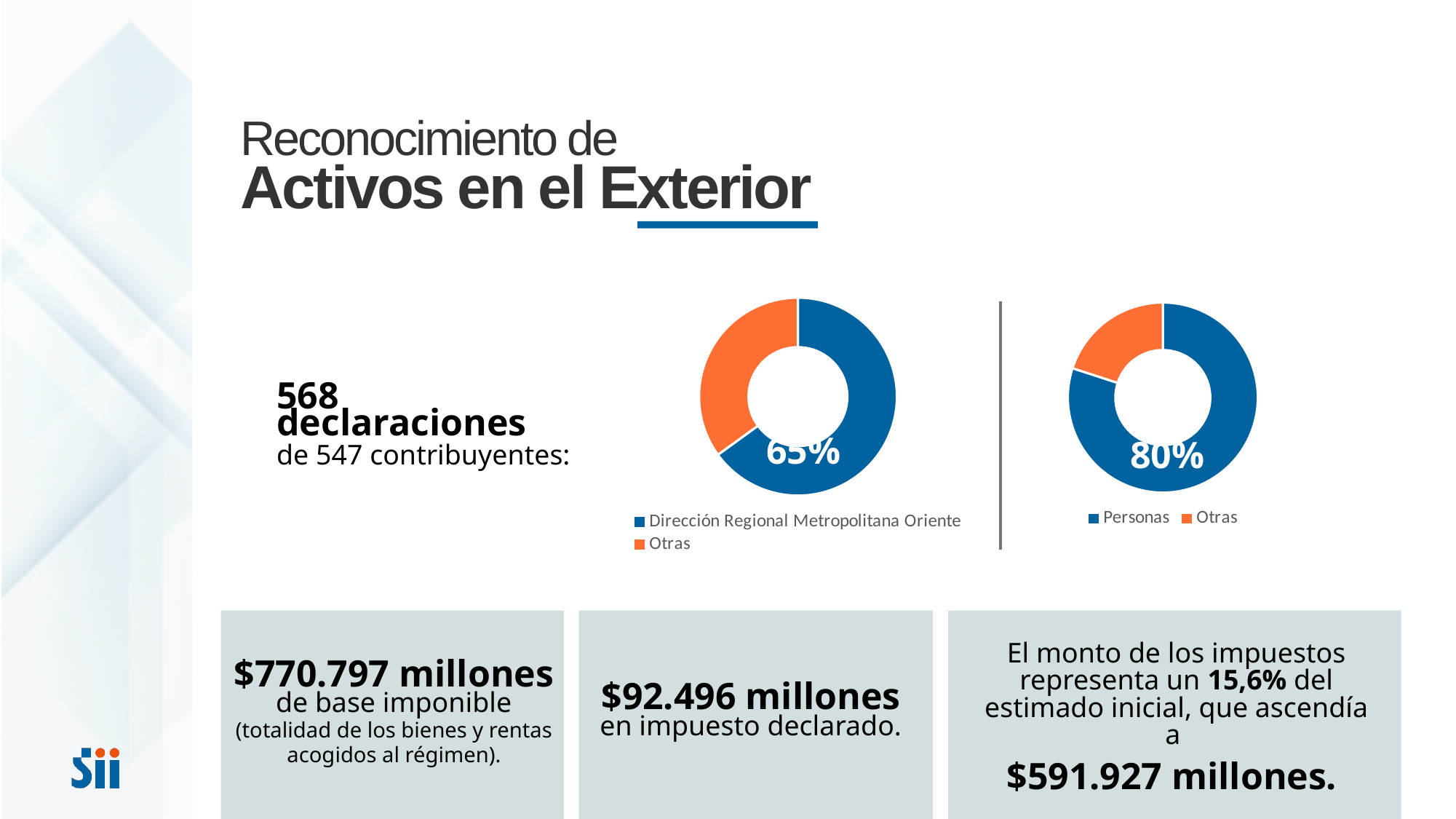
In the left donut chart, which slice is larger, Dirección Regional Metropolitana Oriente or Otras? Dirección Regional Metropolitana Oriente How many categories does the legend of the left donut chart list? 2 How many slices does the right donut chart have? 2 In the right donut chart, what colour represents Otras? Orange In the right donut chart, what share is labelled for Personas? 80% In the right donut chart, which slice is larger, Personas or Otras? Personas In the left donut chart, what colour represents Dirección Regional Metropolitana Oriente? Blue What kind of chart is the left chart on the slide? Donut (pie) chart In the left donut chart, what share is labelled for Dirección Regional Metropolitana Oriente? 65% In the left donut chart, which category has the largest slice? Dirección Regional Metropolitana Oriente In the right donut chart, which category has the smallest slice? Otras What kind of chart is the right chart on the slide? Donut (pie) chart